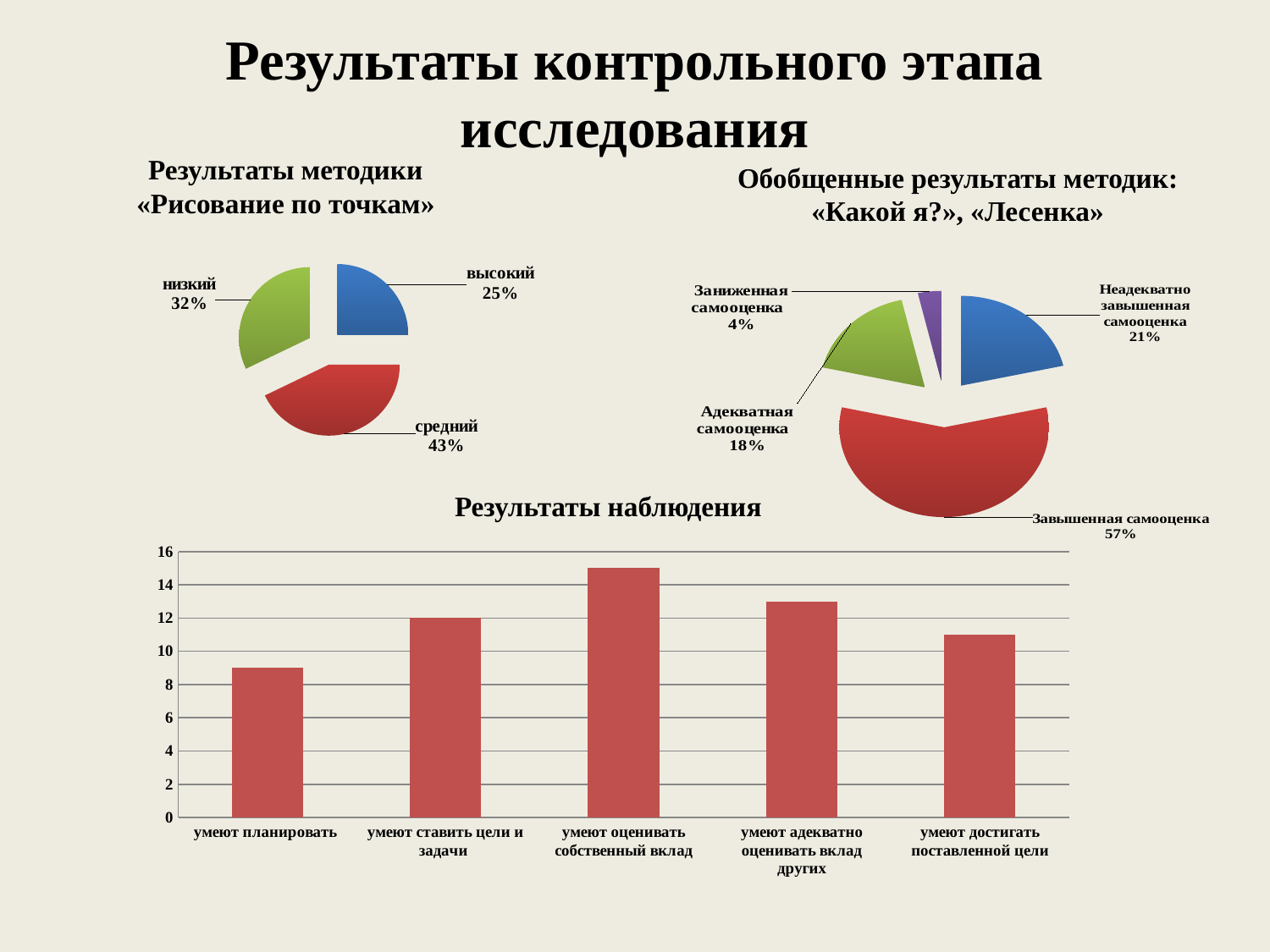
In the pie chart «Рисование по точкам», which category has the smallest share? высокий In the pie chart «Какой я?», «Лесенка», what share is labelled «Адекватная самооценка»? 18% In the pie chart «Рисование по точкам», what is the difference between the «низкий» and «высокий» shares? 7% In the chart «Результаты наблюдения», how many categories are shown on the x axis? 5 What kind of chart is «Результаты наблюдения»? bar chart In the chart «Результаты наблюдения», which category has the highest bar? умеют оценивать собственный вклад In the pie chart «Какой я?», «Лесенка», which is larger: «Неадекватно завышенная самооценка» or «Заниженная самооценка»? Неадекватно завышенная самооценка In the pie chart «Какой я?», «Лесенка», how many slices are there? 4 In the pie chart «Какой я?», «Лесенка», which category has the largest share? Завышенная самооценка In the pie chart «Рисование по точкам», what share is labelled «средний»? 43% In the chart «Результаты наблюдения», is the value for «умеют адекватно оценивать вклад других» greater or less than 12? greater In the chart «Результаты наблюдения», which category has the lowest bar? умеют планировать